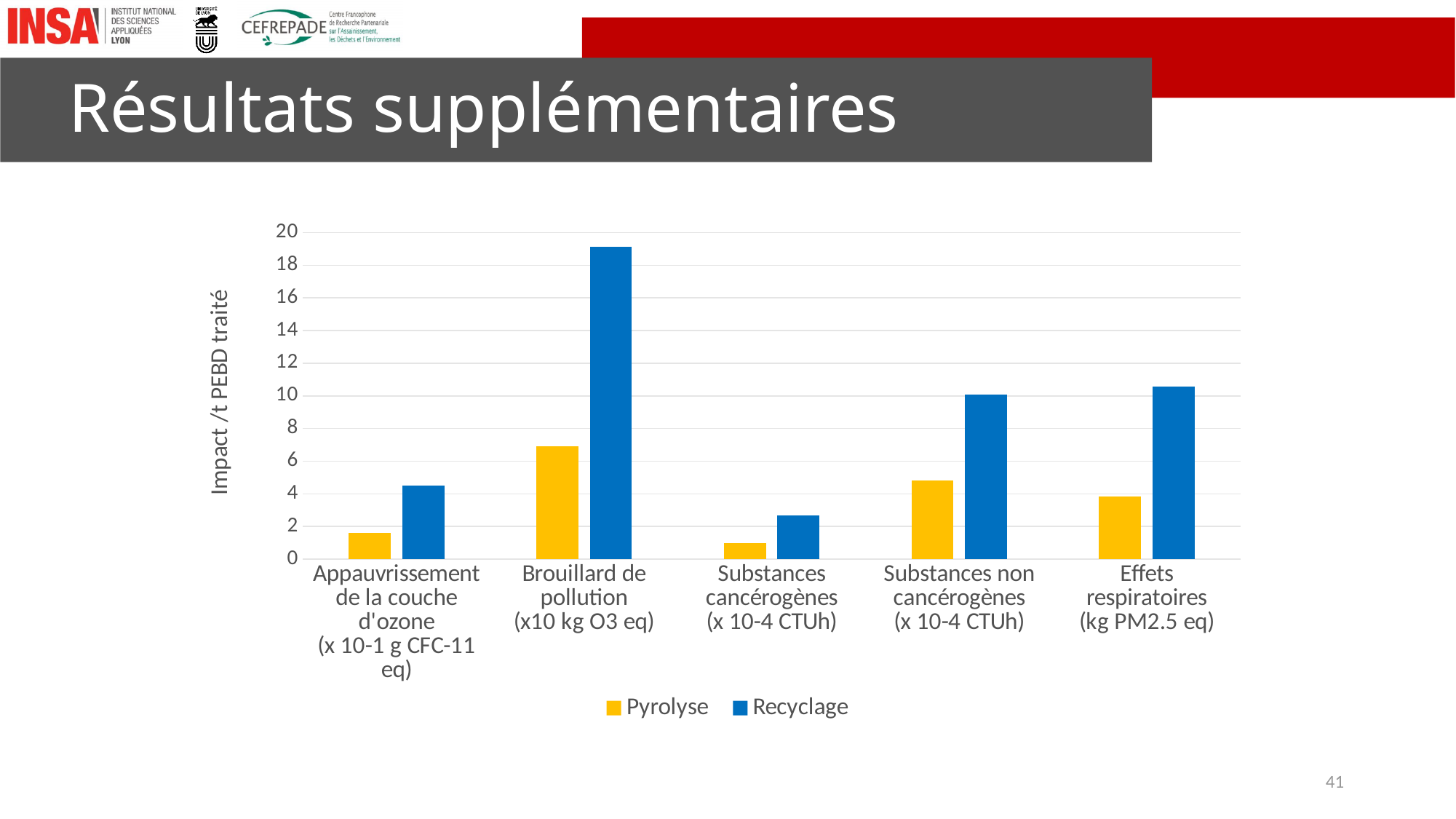
Which is larger for Substances non cancérogènes, the Pyrolyse value or the Recyclage value? Recyclage Is the Recyclage value for Effets respiratoires greater or less than 8? greater Is the Pyrolyse value for Brouillard de pollution greater or less than 8? less Which is larger, the Pyrolyse value for Effets respiratoires or the Pyrolyse value for Substances cancérogènes? Effets respiratoires For which category is the Recyclage value highest? Brouillard de pollution How many series does the legend list? 2 What is the label of the y axis? Impact /t PEBD traité For which category is the Pyrolyse value highest? Brouillard de pollution How many impact categories are shown on the x axis? 5 For which category is the Recyclage value lowest? Substances cancérogènes Is the Recyclage value for Brouillard de pollution greater or less than 18? greater What kind of chart is shown on the slide? bar chart